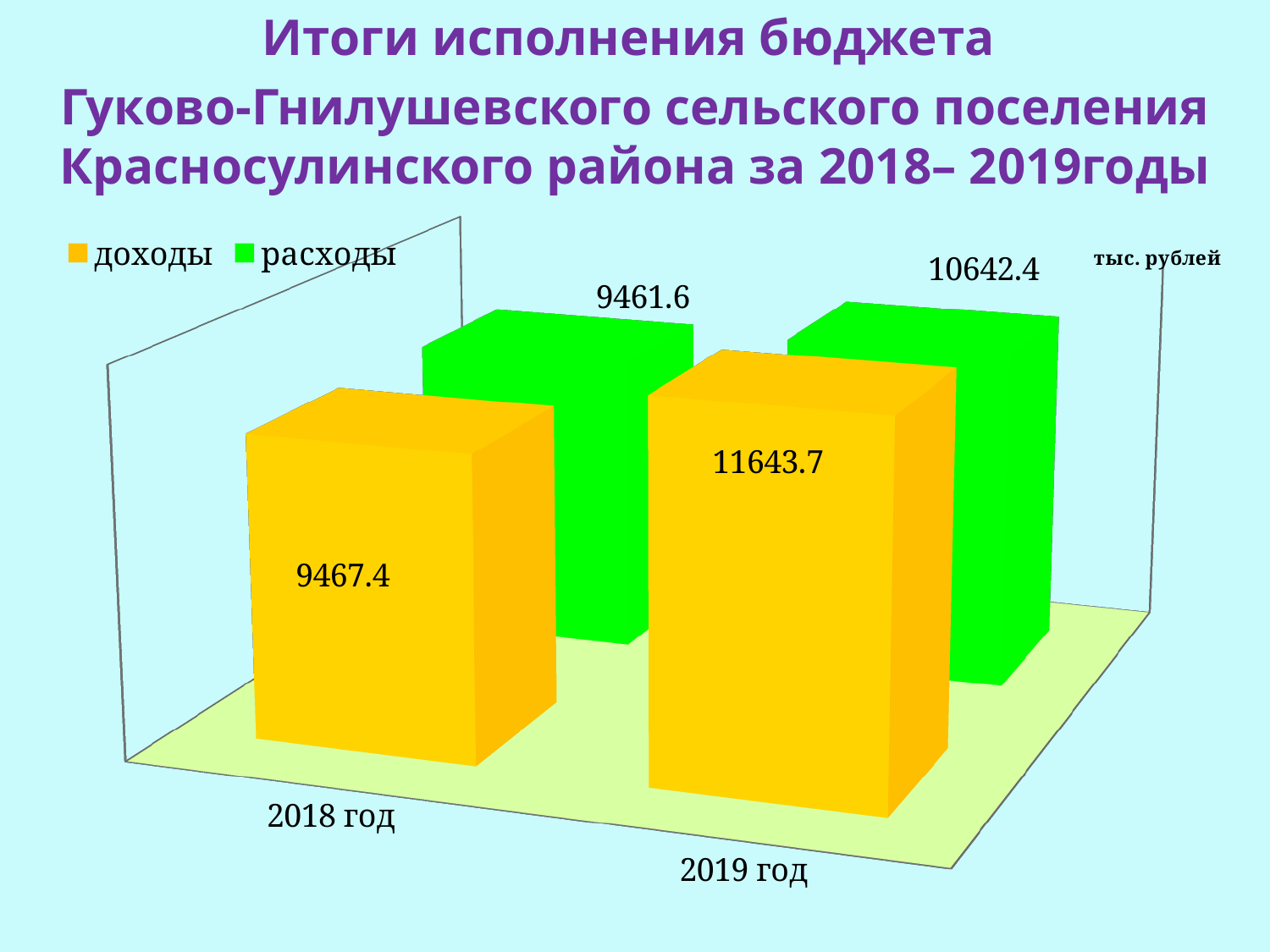
Which year has the higher value for расходы? 2019 год What is the value for доходы in 2019 год? 11643.7 Which bar has the highest value on the chart? доходы, 2019 год By how much did доходы increase from 2018 год to 2019 год? 2176.3 What is the difference between доходы and расходы in 2019 год? 1001.3 What is the value for расходы in 2018 год? 9461.6 Which year has the higher value for доходы? 2019 год What is the value for расходы in 2019 год? 10642.4 What kind of chart is shown on the slide? bar chart What is the value for доходы in 2018 год? 9467.4 In 2019 год, which is larger, доходы or расходы? доходы How many series does the legend list? 2